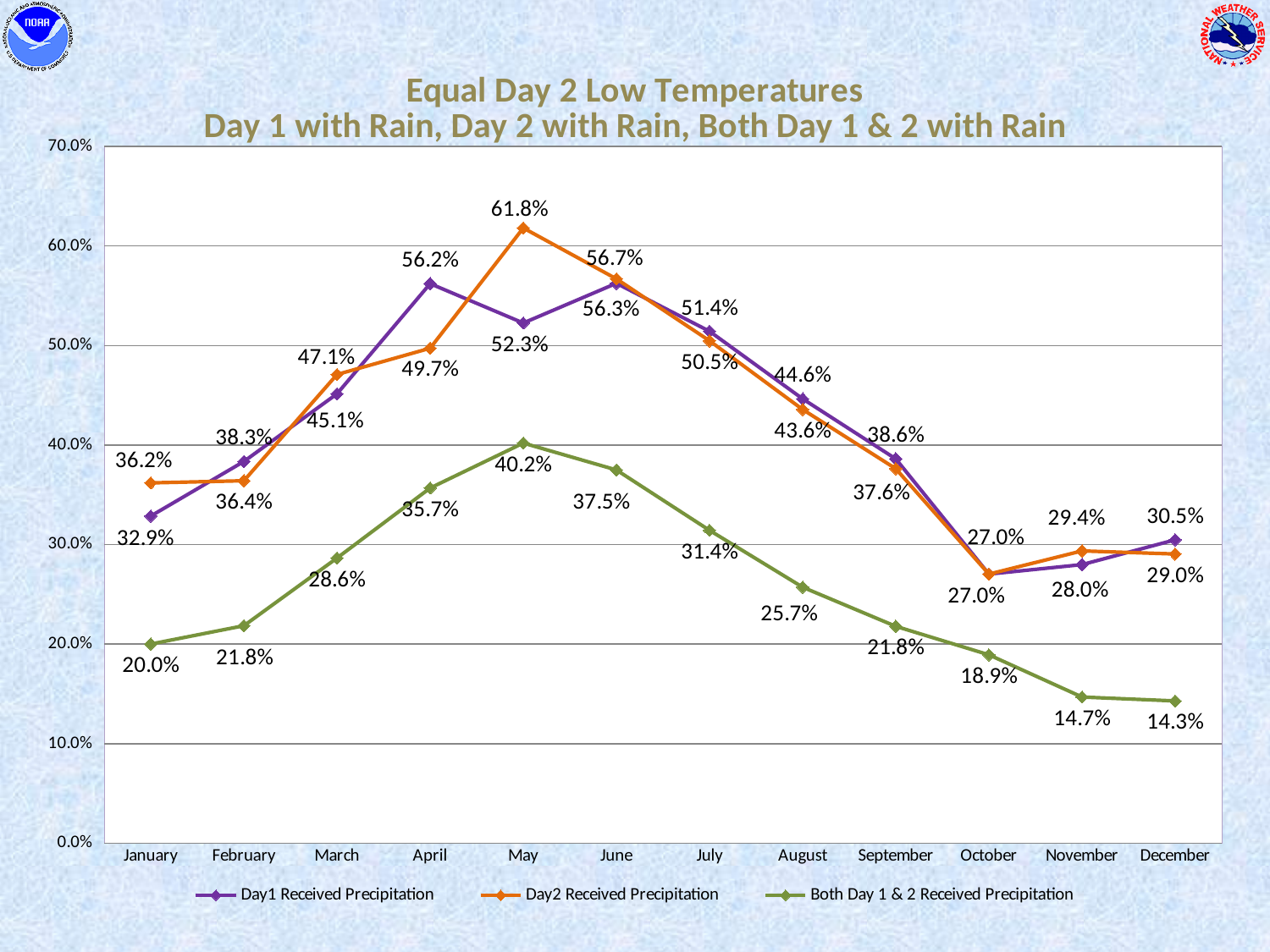
What type of chart is shown on the slide? line chart In which month is the Both Day 1 & 2 Received Precipitation series lowest? December How many series does the legend list? 3 How many months are plotted along the x axis? 12 Does the Both Day 1 & 2 Received Precipitation series rise or fall from May to December? fall What is the title of the chart? Equal Day 2 Low Temperatures Day 1 with Rain, Day 2 with Rain, Both Day 1 & 2 with Rain What is the value for Day1 Received Precipitation in April? 56.2% In which month is the Both Day 1 & 2 Received Precipitation series highest? May Which is larger in April: Day1 Received Precipitation or Day2 Received Precipitation? Day1 Received Precipitation What is the value for Day2 Received Precipitation in May? 61.8% What is the value for Both Day 1 & 2 Received Precipitation in October? 18.9% What is the difference between Day2 Received Precipitation and Day1 Received Precipitation in May? 9.5%